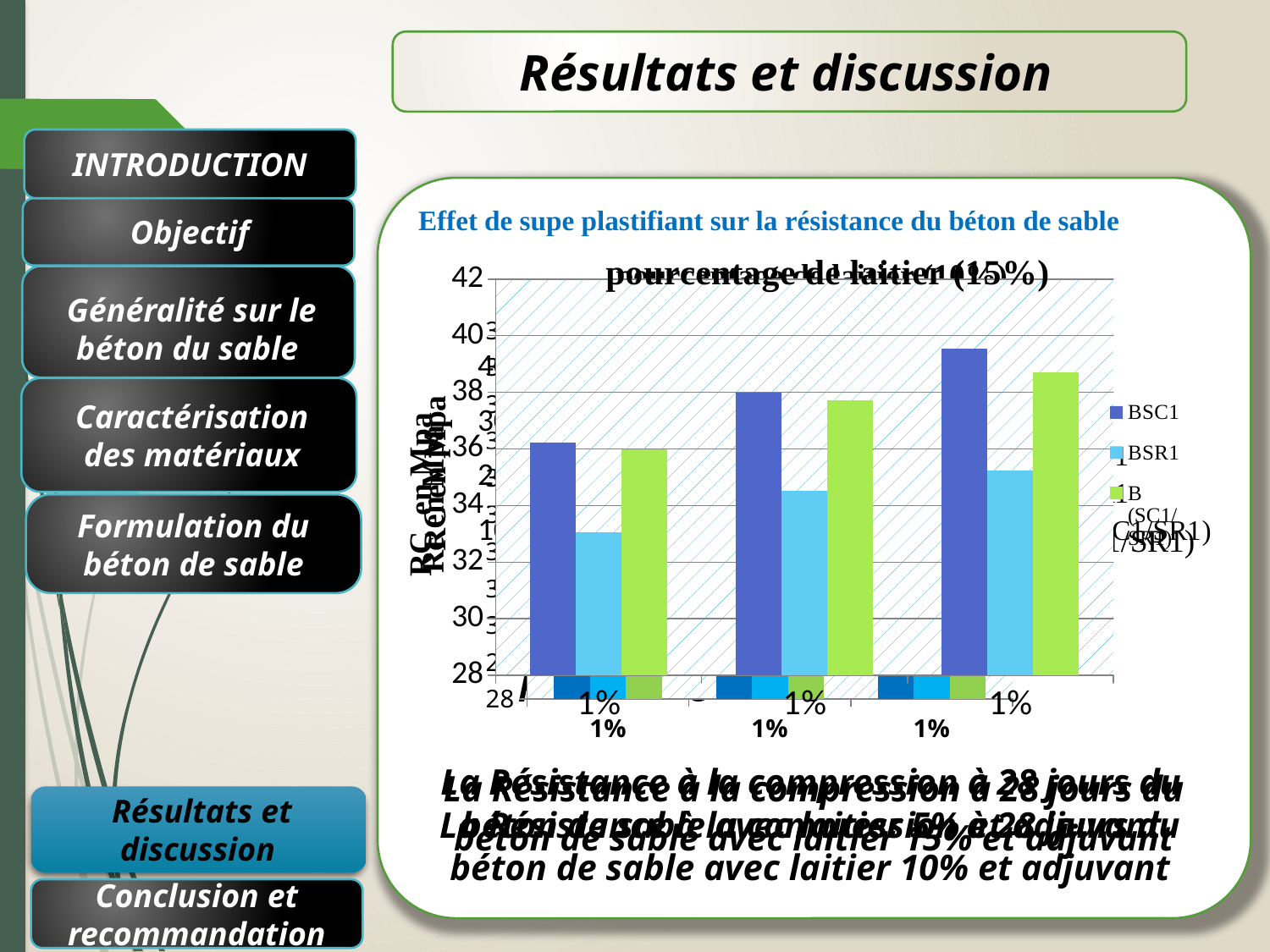
In the large bar chart, what colour are the BSR1 bars? light blue How many groups of bars are plotted in the large bar chart? 3 What kind of chart is the large chart on the slide? bar chart In the large bar chart, is the B (SC1/SR1) bar in the third group greater or less than 38? greater In the large bar chart, which is larger in the first group: BSC1 or BSR1? BSC1 In the large bar chart, is the BSR1 bar in the second group greater or less than 36? less In the large bar chart, do the BSC1 bars rise or fall from the first group to the third group? rise In the large bar chart, is the BSC1 bar in the third group greater or less than 38? greater In the large bar chart, which series has the shortest bar overall? BSR1 In the large bar chart, which series has the tallest bar overall? BSC1 How many series does the legend of the large bar chart list? 3